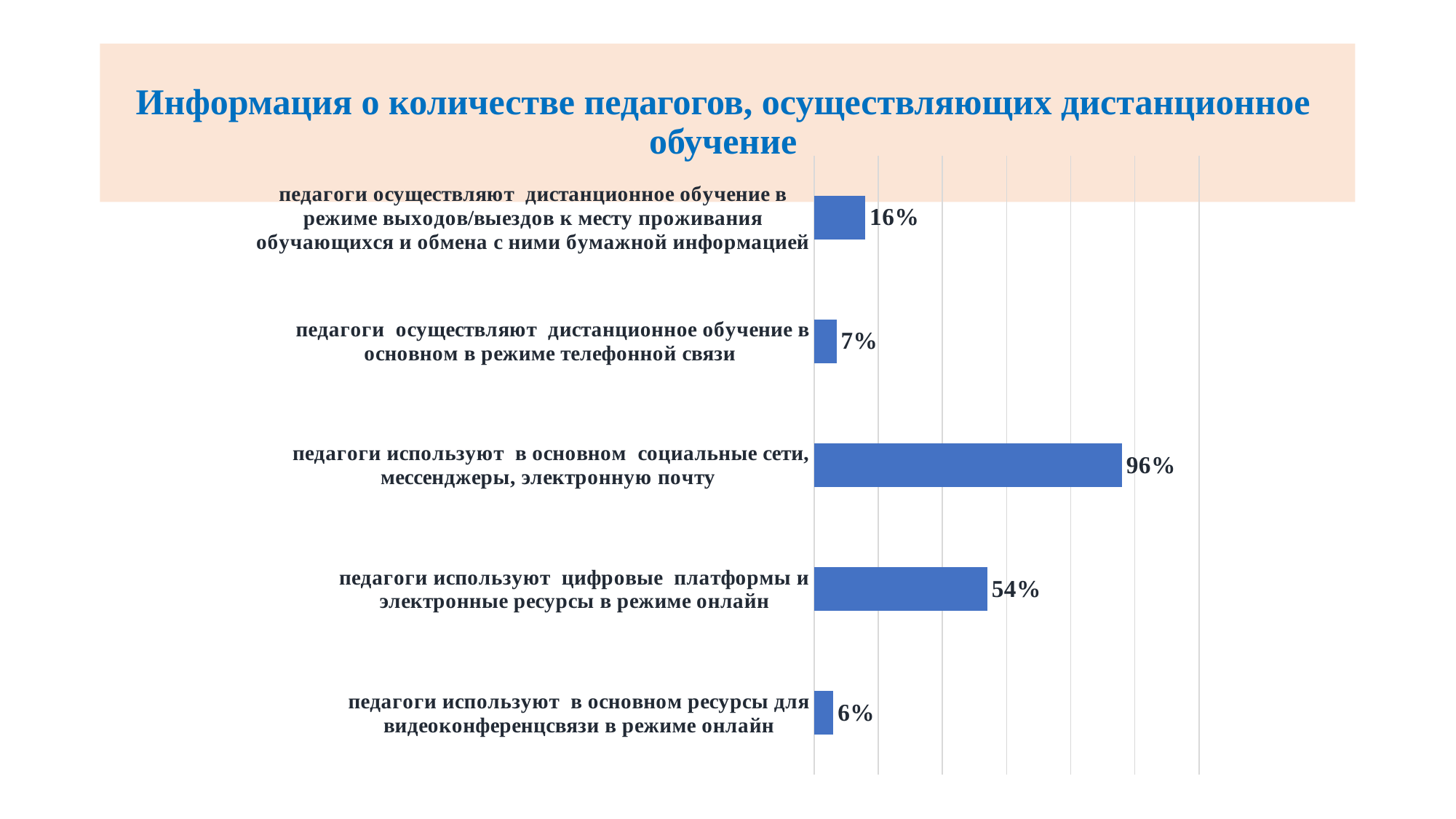
What is the value for "педагоги осуществляют дистанционное обучение в основном в режиме телефонной связи"? 7% What is the value for "педагоги используют цифровые платформы и электронные ресурсы в режиме онлайн"? 54% How many categories are shown in the chart? 5 What is the difference between the value for social networks/messengers/e-mail (96%) and the value for digital platforms and online resources (54%)? 42% What percentage of teachers use mainly social networks, messengers and e-mail ("педагоги используют в основном социальные сети, мессенджеры, электронную почту")? 96% What is the value for teachers who conduct distance learning by visiting students' homes and exchanging paper materials ("в режиме выходов/выездов к месту проживания обучающихся")? 16% Which category has the lowest value? педагоги используют в основном ресурсы для видеоконференцсвязи в режиме онлайн What is the value for "педагоги используют в основном ресурсы для видеоконференцсвязи в режиме онлайн"? 6% What type of chart is shown on the slide? bar chart What is the title of the slide? Информация о количестве педагогов, осуществляющих дистанционное обучение Which is larger: the value for distance learning by telephone or the value for home visits with paper materials? home visits with paper materials (16%) Which category has the highest value? педагоги используют в основном социальные сети, мессенджеры, электронную почту